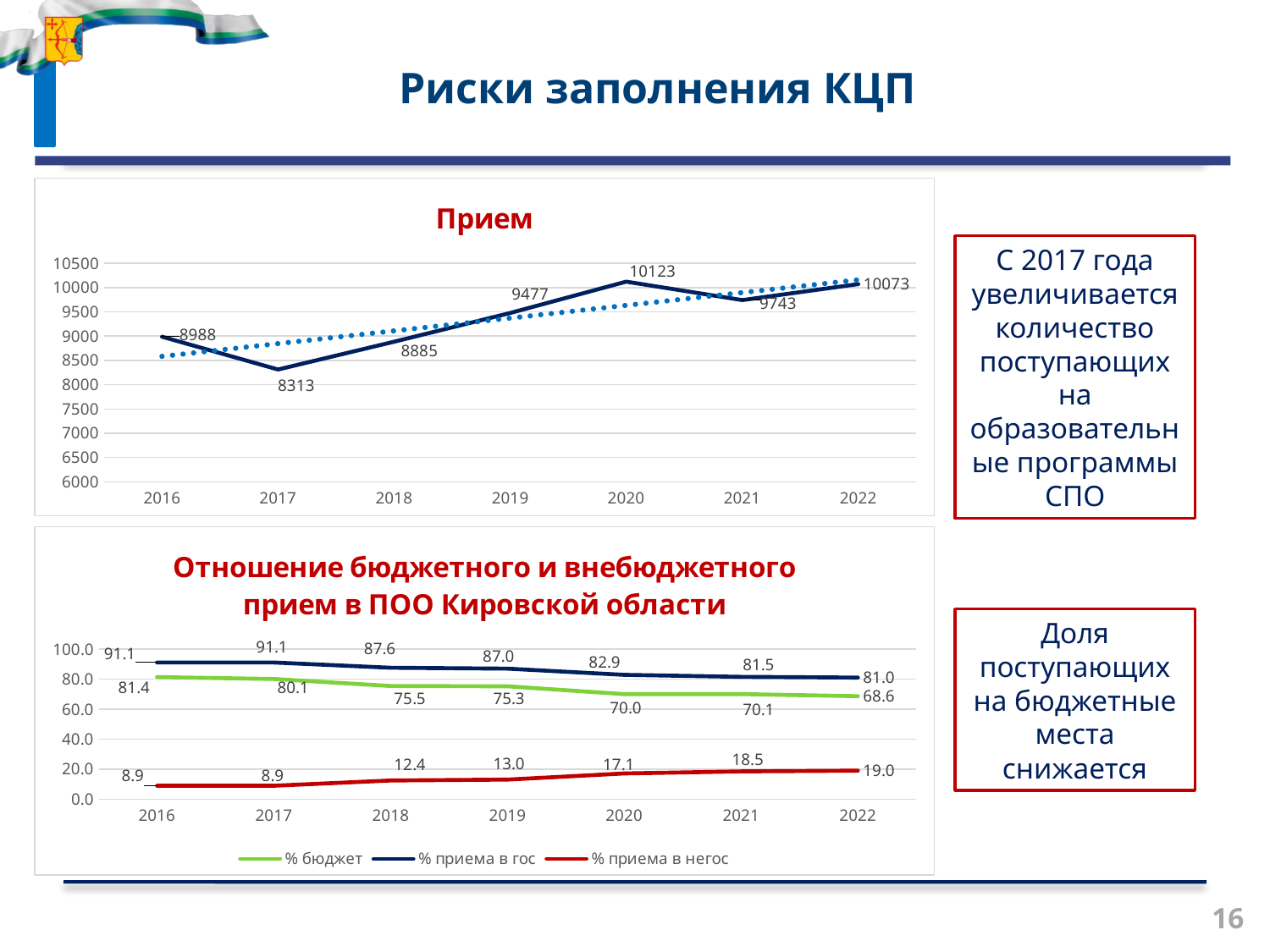
In the 'Отношение бюджетного и внебюджетного прием в ПОО Кировской области' chart, what is the value of '% приема в негос' for 2022? 19.0 In the 'Отношение бюджетного и внебюджетного прием в ПОО Кировской области' chart, how many series does the legend list? 3 In the 'Отношение бюджетного и внебюджетного прием в ПОО Кировской области' chart, what is the difference between '% приема в гос' and '% приема в негос' in 2016? 82.2 In the 'Прием' chart, which year has the highest value? 2020 In the 'Отношение бюджетного и внебюджетного прием в ПОО Кировской области' chart, which series is shown in red? % приема в негос In the 'Прием' chart, how many years are shown on the x axis? 7 In the 'Прием' chart, which year has the lowest value? 2017 In the 'Отношение бюджетного и внебюджетного прием в ПОО Кировской области' chart, does '% приема в негос' rise or fall from 2016 to 2022? Rise What type of chart is the 'Прием' chart? Line chart In the 'Отношение бюджетного и внебюджетного прием в ПОО Кировской области' chart, what is the value of '% бюджет' for 2019? 75.3 In the 'Прием' chart, what is the difference between the 2022 value and the 2017 value? 1760 In the 'Прием' chart, what is the value for 2020? 10123